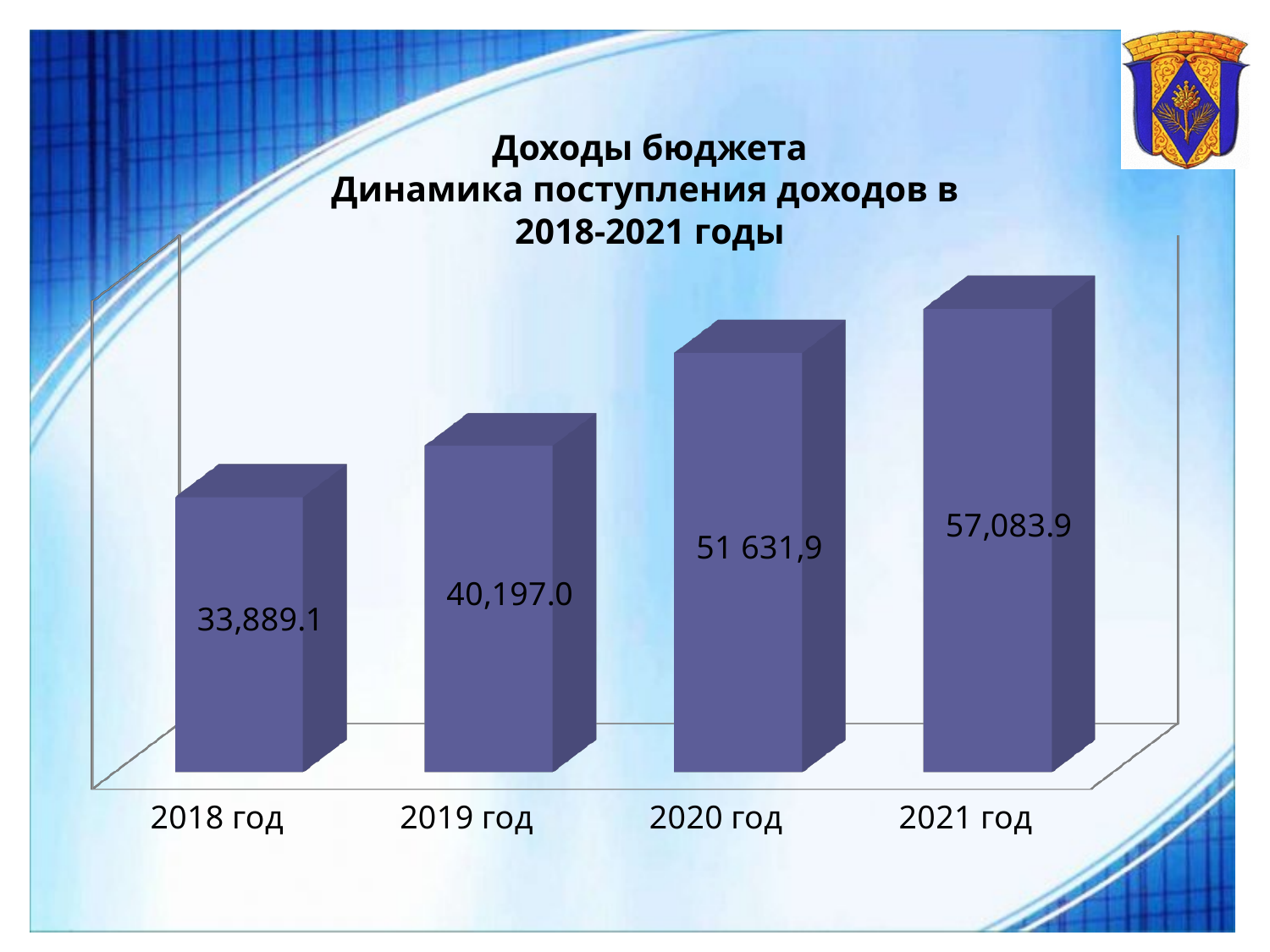
Do the values rise or fall from 2018 год to 2021 год? Rise What is the difference between the values for 2019 год and 2018 год? 6,307.9 How many years (bars) are shown in the chart? 4 What is the value shown for 2019 год? 40,197.0 What is the value shown for 2020 год? 51 631,9 What is the value shown for 2021 год? 57,083.9 Which is larger, the value for 2020 год or the value for 2019 год? 2020 год What is the value shown for 2018 год? 33,889.1 Which year has the lowest value? 2018 год What is the difference between the values for 2021 год and 2018 год? 23,194.8 What kind of chart is shown on the slide? Bar chart Which year has the highest value? 2021 год